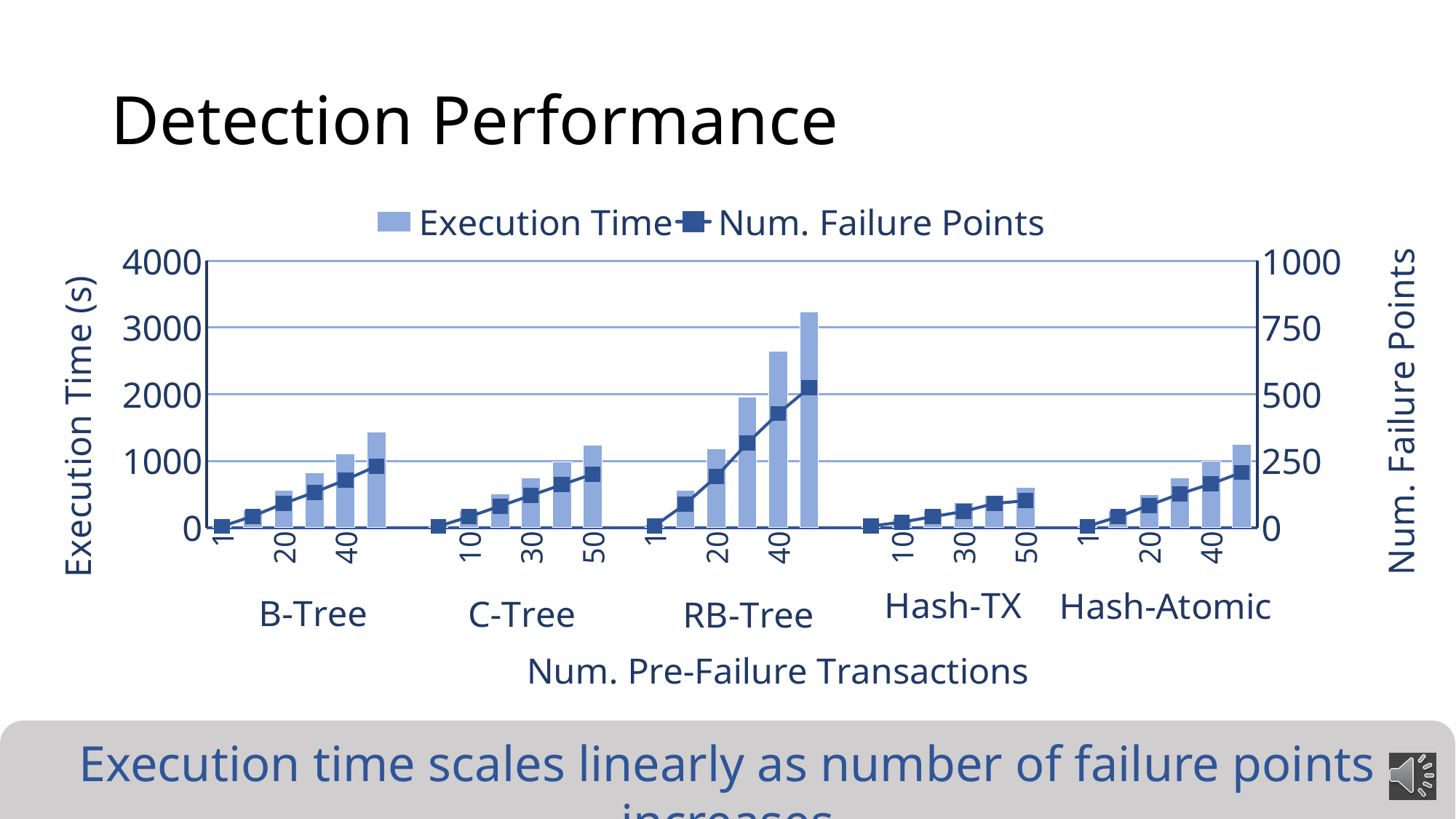
Which data structure has the lowest execution time bars? Hash-TX Within each data structure, does execution time rise or fall as the number of pre-failure transactions increases? rise Which data structure has the highest execution time bars? RB-Tree What kind of chart is shown on the slide? A combined bar and line chart Is the execution time for Hash-TX at 50 pre-failure transactions greater or less than 1000? less Is the execution time for RB-Tree at 50 pre-failure transactions greater or less than 3000? greater What are the two series named in the legend? Execution Time and Num. Failure Points How many data structures (groups) are shown along the x axis? 5 Is the execution time for B-Tree at 50 pre-failure transactions greater or less than 1000? greater Which has the larger execution time at 50 pre-failure transactions, RB-Tree or C-Tree? RB-Tree What is the label of the right-hand vertical axis? Num. Failure Points How many series does the legend list? 2